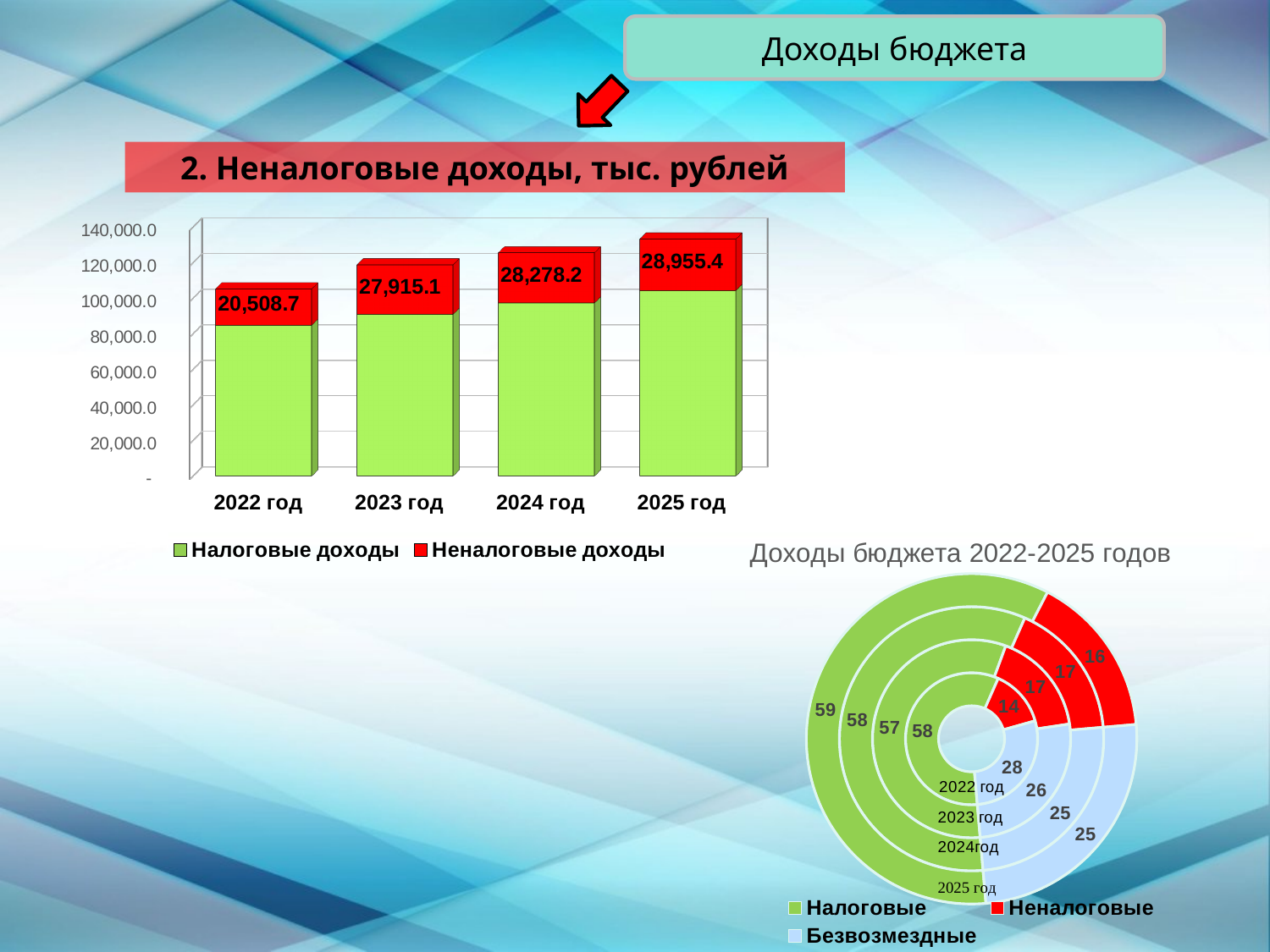
In the bar chart '2. Неналоговые доходы, тыс. рублей', how many years are shown on the x axis? 4 In the bar chart '2. Неналоговые доходы, тыс. рублей', what is the value of Неналоговые доходы for 2025 год? 28,955.4 In the bar chart '2. Неналоговые доходы, тыс. рублей', do the Неналоговые доходы values rise or fall from 2022 год to 2025 год? rise In the bar chart '2. Неналоговые доходы, тыс. рублей', what is the difference between Неналоговые доходы in 2023 год and 2022 год? 7,406.4 In the bar chart '2. Неналоговые доходы, тыс. рублей', how many series does the legend list? 2 In the doughnut chart 'Доходы бюджета 2022-2025 годов', what is the value for Безвозмездные in 2022 год? 28 In the bar chart '2. Неналоговые доходы, тыс. рублей', which year has the highest Неналоговые доходы? 2025 год In the doughnut chart 'Доходы бюджета 2022-2025 годов', how many series does the legend list? 3 In the bar chart '2. Неналоговые доходы, тыс. рублей', what is the value of Неналоговые доходы for 2022 год? 20,508.7 What kind of chart is '2. Неналоговые доходы, тыс. рублей'? bar chart In the bar chart '2. Неналоговые доходы, тыс. рублей', is the total height of the 2022 год bar greater or less than 120,000.0? less In the bar chart '2. Неналоговые доходы, тыс. рублей', which year has the lowest Неналоговые доходы? 2022 год